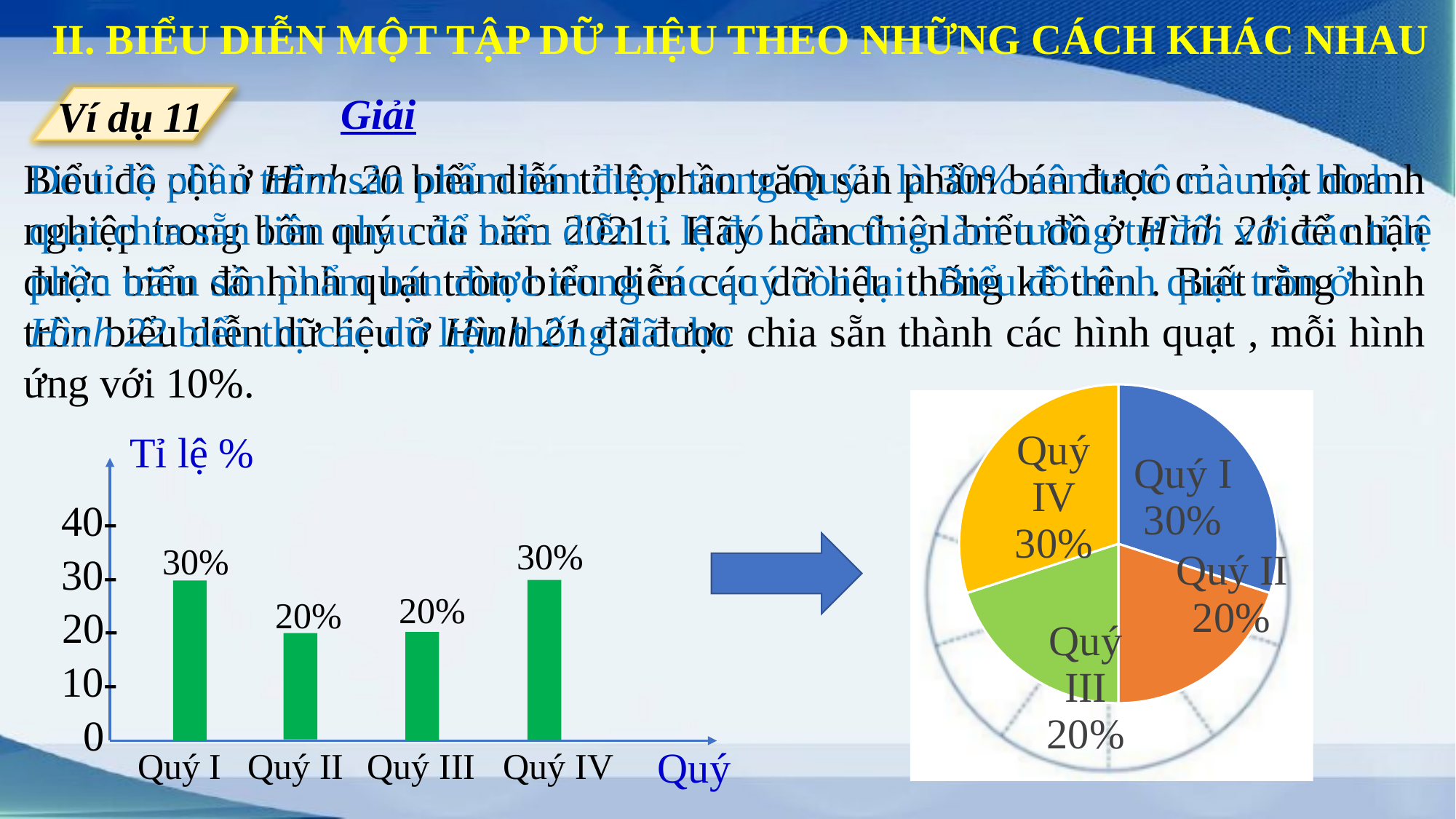
In the bar chart on the left, what is the value for Quý IV? 30% What kind of chart is the chart on the right of the slide? pie chart How many slices does the pie chart on the right have? 4 In the pie chart on the right, what share does Quý III have? 20% How many categories are shown in the bar chart on the left? 4 What kind of chart is the chart on the left of the slide? bar chart What is the label on the vertical axis of the bar chart on the left? Tỉ lệ % In the bar chart on the left, is the value for Quý IV greater or less than 20? greater In the bar chart on the left, what is the difference between the values for Quý I and Quý III? 10% In the bar chart on the left, what is the value for Quý II? 20% In the bar chart on the left, which is larger, the value for Quý I or the value for Quý II? Quý I In the pie chart on the right, what share does Quý I have? 30%